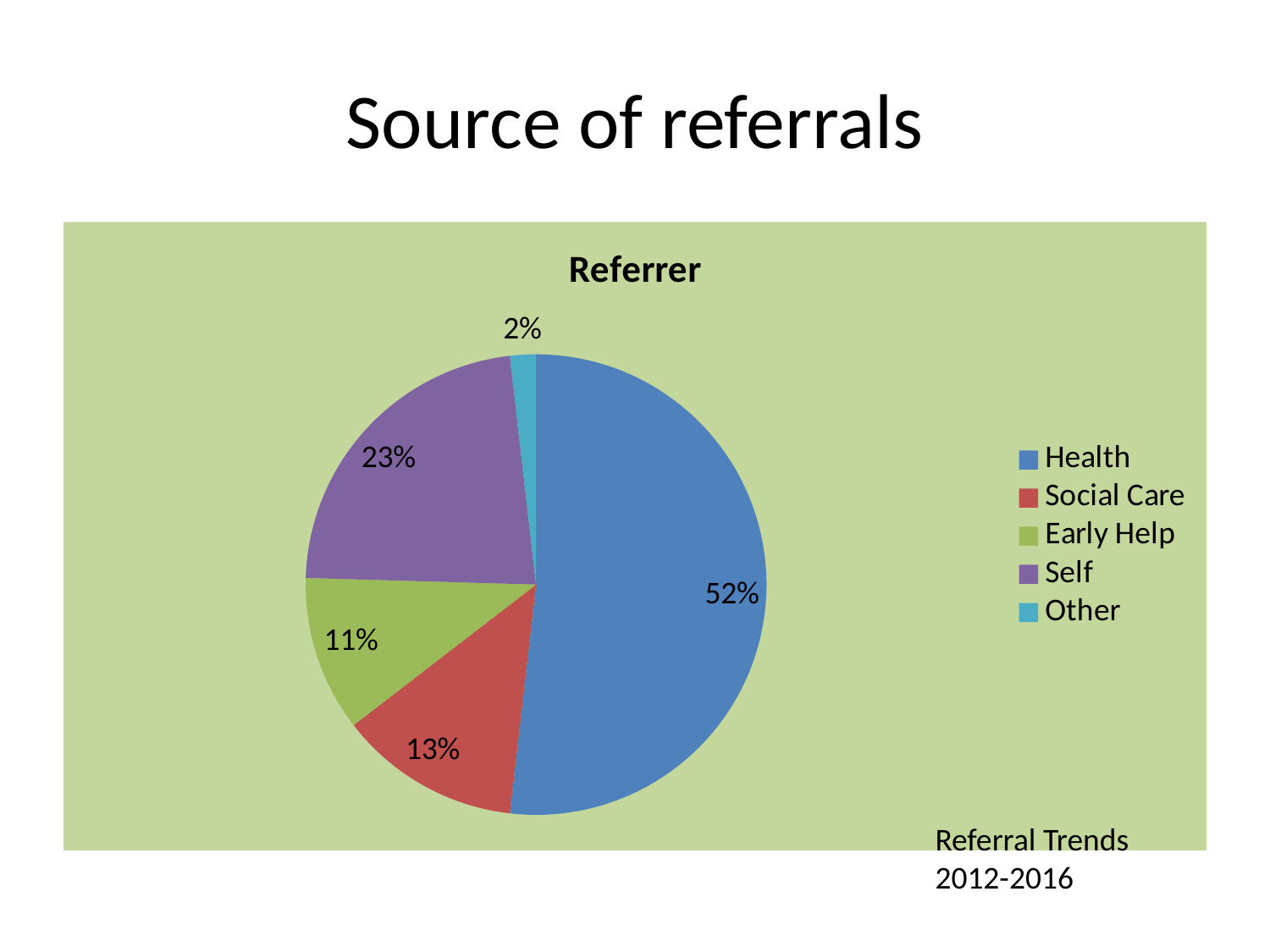
What type of chart is shown on the slide? pie chart What is the chart's title? Referrer What share of referrals comes from Early Help? 11% Which referrer category has the smallest share? Other How many categories does the pie chart show? 5 What is the difference in percentage points between the Health share and the Self share? 29 What share of referrals comes from Social Care? 13% What share of referrals comes from Health? 52% Which referrer category has the largest share? Health Which is larger, the share for Social Care or the share for Early Help? Social Care